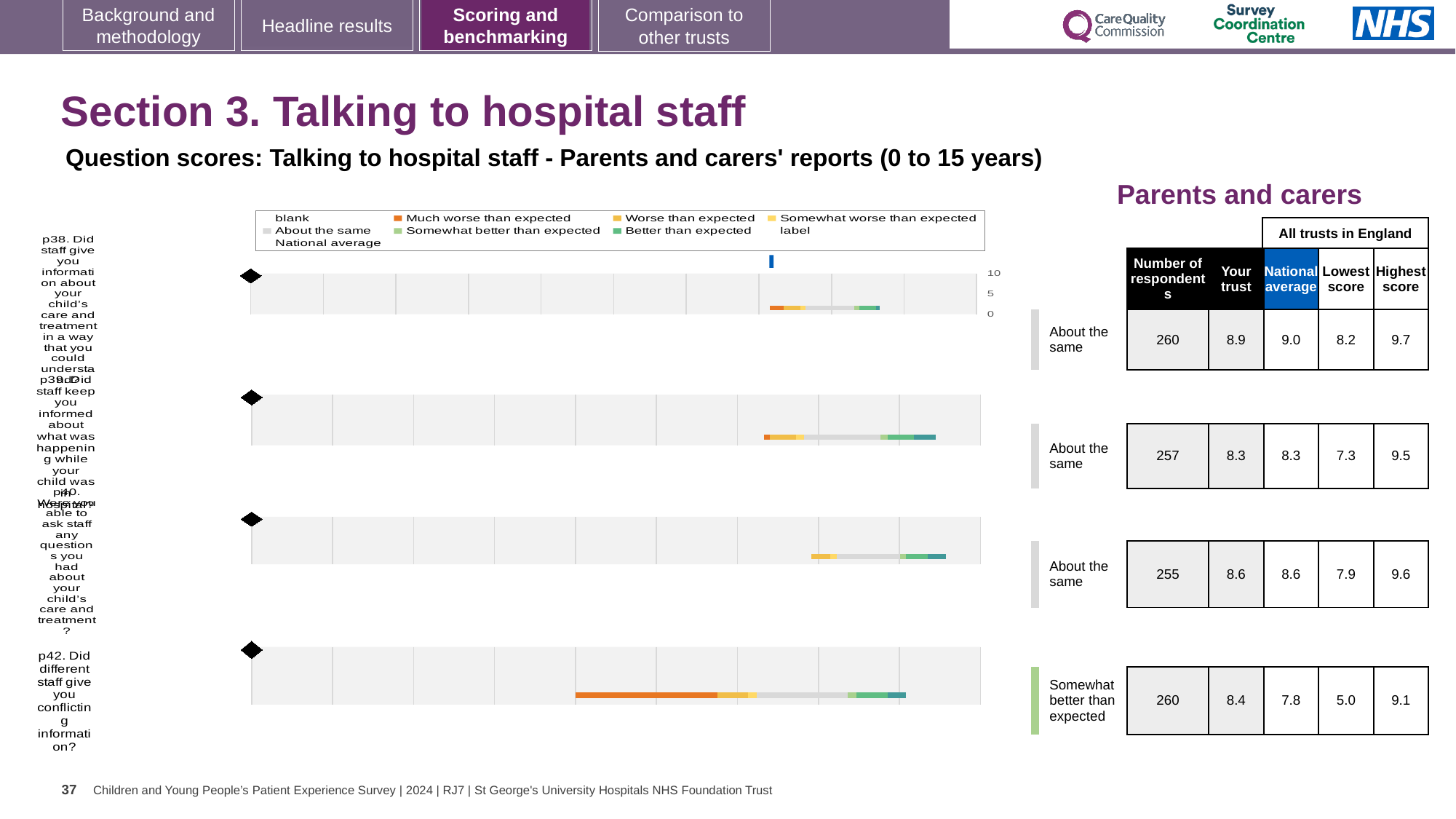
In the chart legend, what colour represents 'Much worse than expected'? orange In the table next to the charts, how many respondents are listed for p39 (staff keeping you informed about what was happening)? 257 Which has the larger 'Your trust' score in the table next to the charts, p39 or p40? p40 In the table next to the charts, what is the 'Your trust' score for p38 (staff giving information about your child's care in a way you could understand)? 8.9 What benchmark category is shown for p42 (different staff giving conflicting information)? Somewhat better than expected For p42, what is the difference between the 'Your trust' score and the National average in the table next to the charts? 0.6 In the table next to the charts, what is the National average score for p42 (different staff giving conflicting information)? 7.8 In the table next to the charts, what is the Highest score for p40 (being able to ask staff any questions)? 9.6 Which question has the lowest 'Lowest score' value in the table next to the charts? p42 What kind of chart is used to show the benchmark bands for each question on this slide? bar chart Which question has the highest 'Your trust' score in the table next to the charts? p38 How many question charts (p38, p39, p40, p42) are shown on the slide? 4